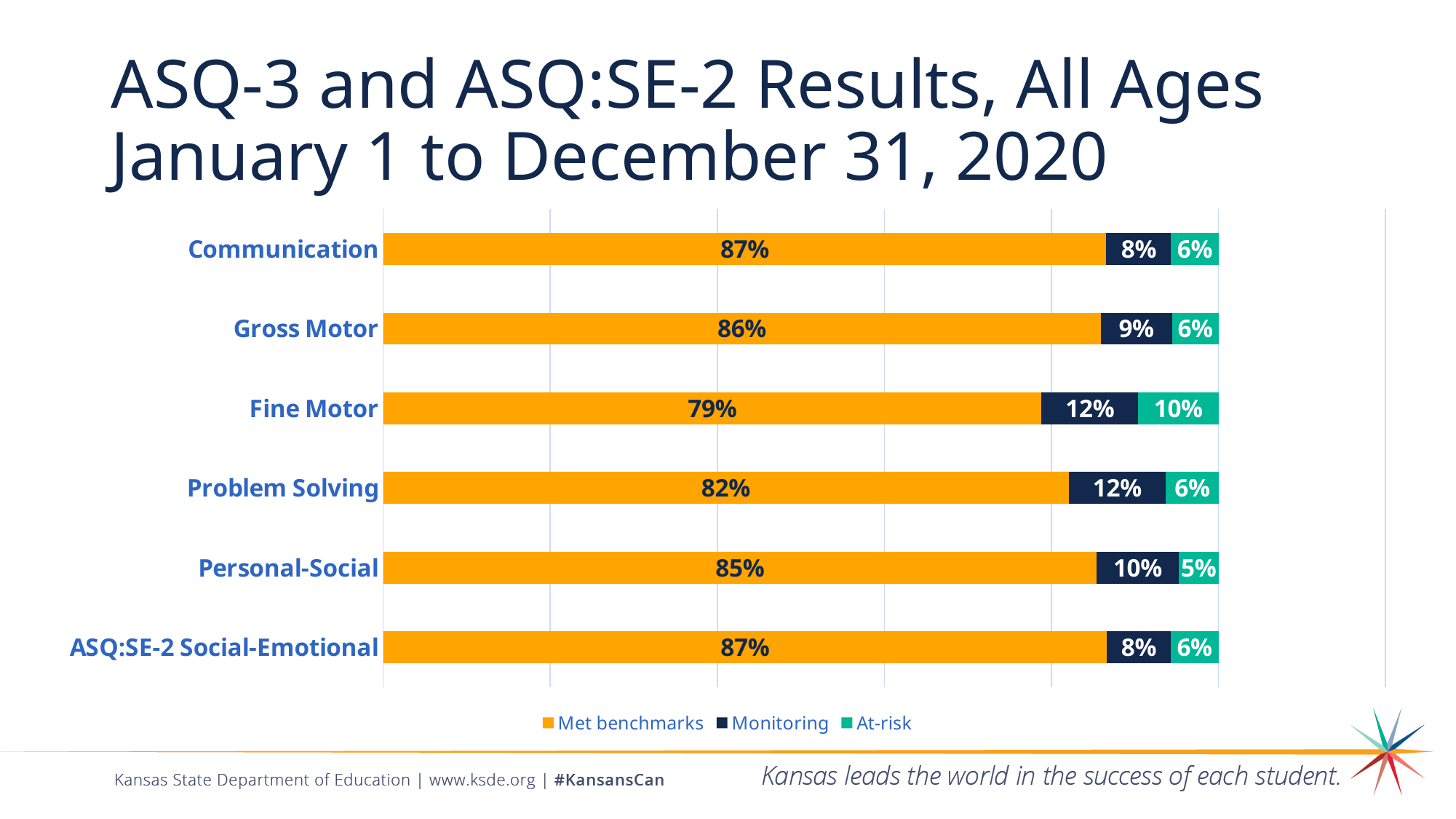
How many series does the legend list? 3 Which has a larger Monitoring value, Gross Motor or Personal-Social? Personal-Social How many percentage points higher is the Met benchmarks value for Communication than for Fine Motor? 8 percentage points What type of chart is shown on the slide? Stacked bar chart What percentage of children met benchmarks in the Fine Motor domain? 79% Which domain has the highest At-risk percentage? Fine Motor What is the At-risk value for Personal-Social? 5% Which domain has the lowest Met benchmarks percentage? Fine Motor What is the Met benchmarks value for Gross Motor? 86% How many domains are shown on the chart? 6 What is the Monitoring value for Problem Solving? 12% Which domain has the lowest At-risk percentage? Personal-Social